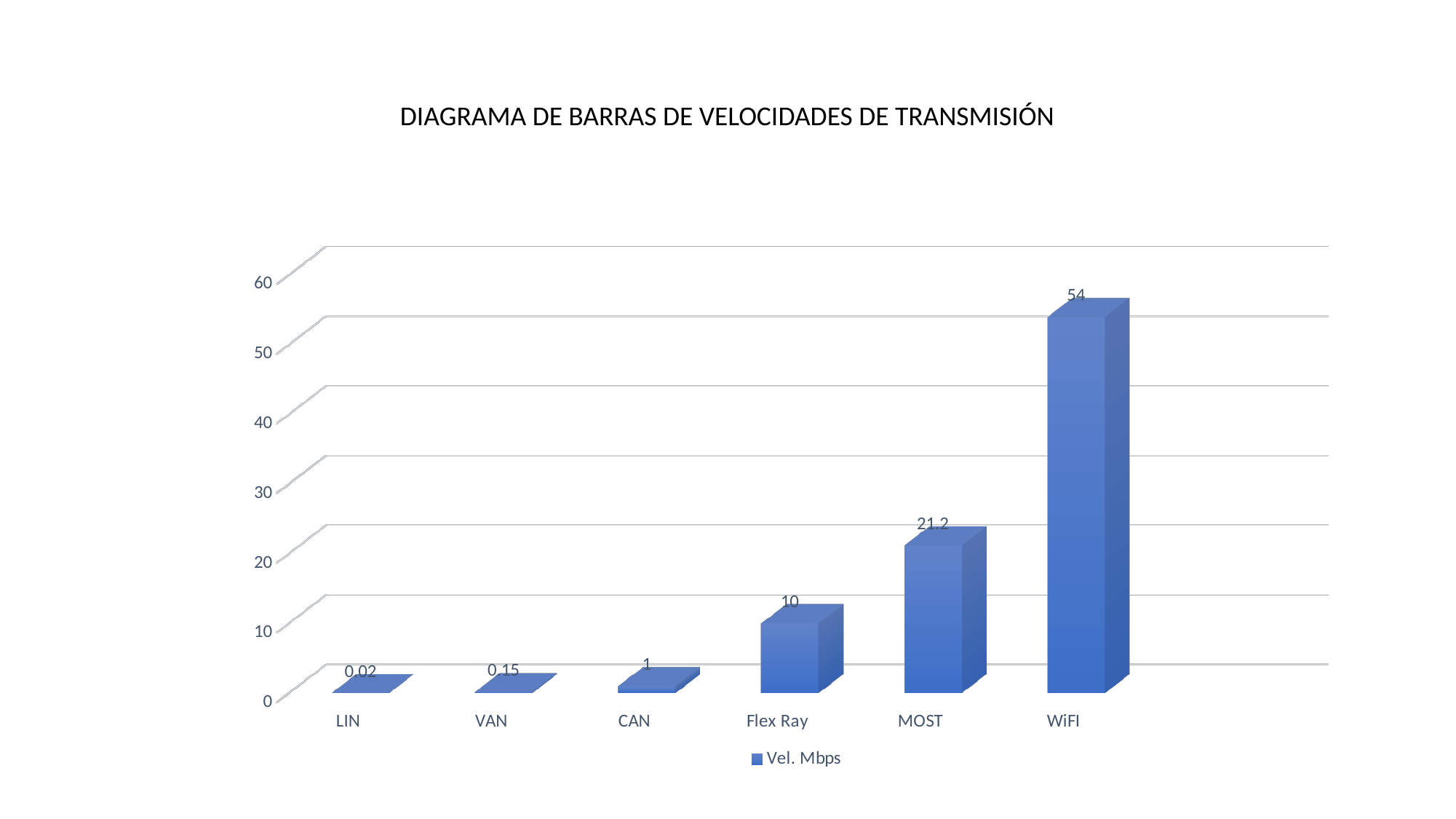
Which is larger, the value for CAN or the value for VAN? CAN What kind of chart is shown? Bar chart What is the value for LIN? 0.02 What is the value for WiFI? 54 How many categories are shown on the x axis? 6 Which category has the highest value? WiFI What is the name of the series shown in the legend? Vel. Mbps What is the value for MOST? 21.2 Is the value for WiFI greater or less than 50? greater Which category has the lowest value? LIN What is the value for Flex Ray? 10 What is the difference between the values for WiFI and MOST? 32.8